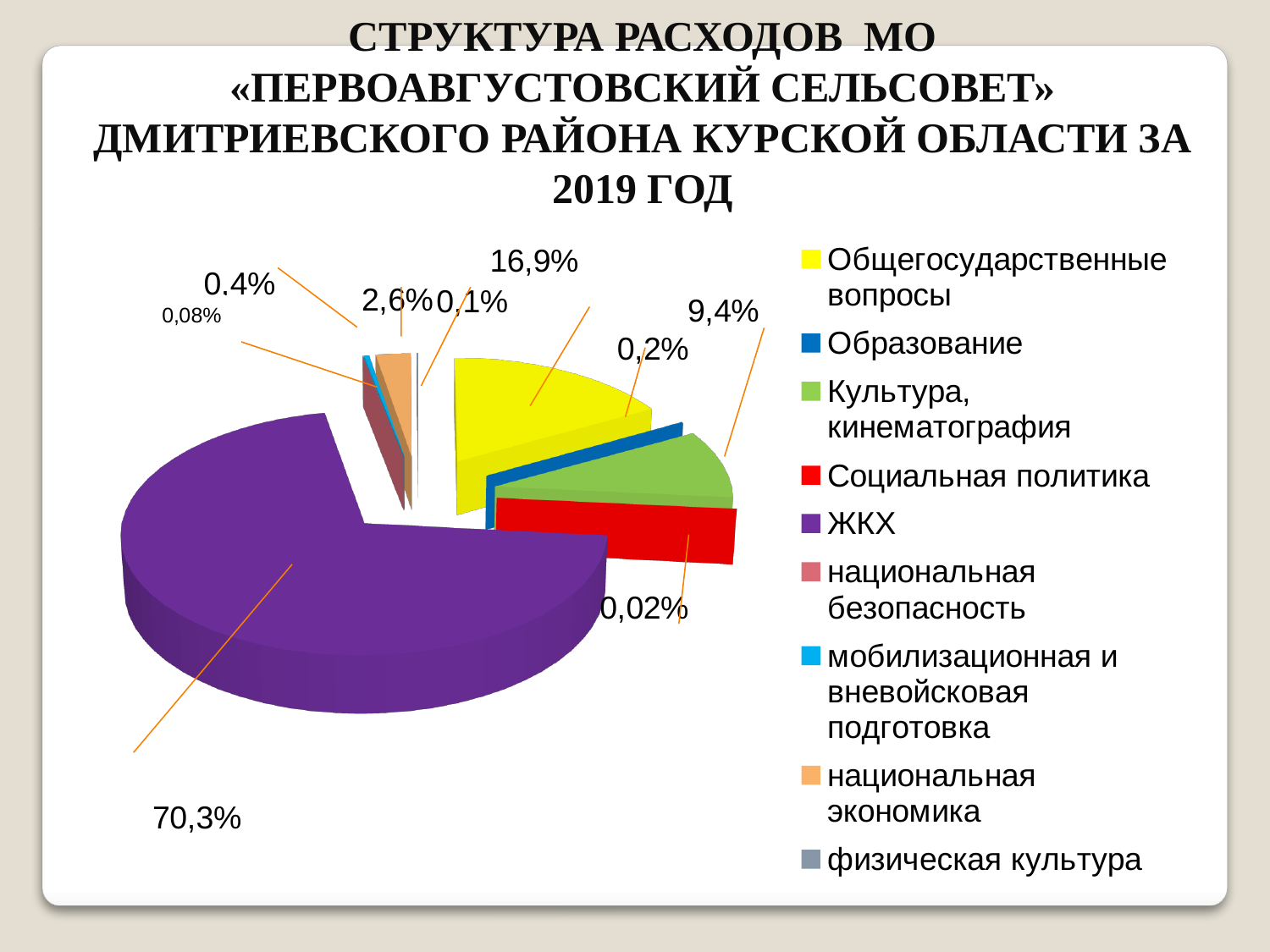
What share of expenditures does ЖКХ account for? 70,3% Which has a larger share: Культура, кинематография or Общегосударственные вопросы? Общегосударственные вопросы How many categories does the legend of the pie chart list? 9 What share of expenditures does Образование account for? 0,2% What share of expenditures does Общегосударственные вопросы account for? 16,9% For which year does the chart show the structure of expenditures? 2019 What share of expenditures does национальная экономика account for? 2,6% What kind of chart is shown on the slide? pie chart Which category has the largest share of expenditures in the pie chart? ЖКХ What share of expenditures does Культура, кинематография account for? 9,4% By how many percentage points does the share of ЖКХ exceed the share of Общегосударственные вопросы? 53,4 What colour is the ЖКХ slice in the pie chart? purple